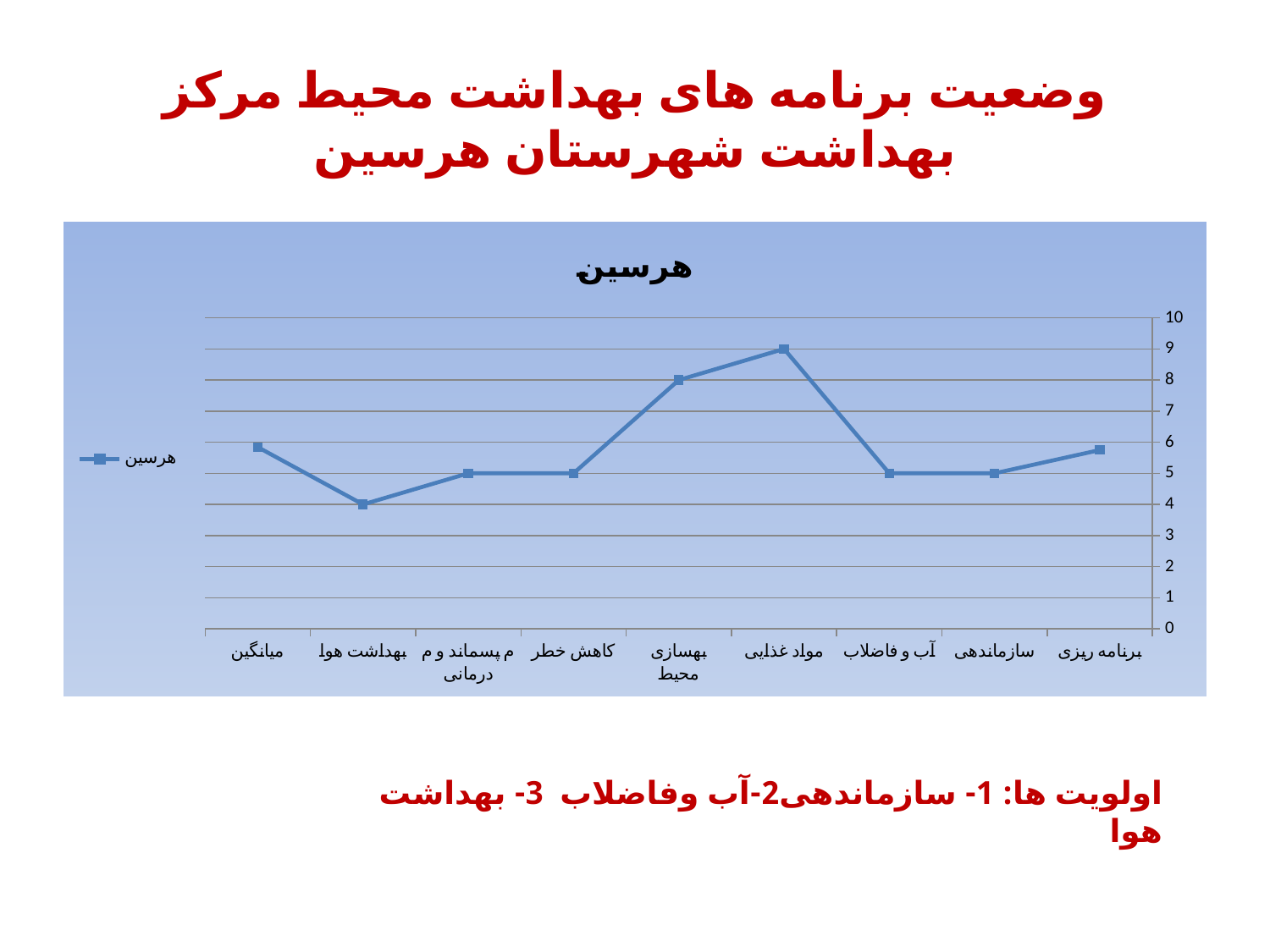
What is the value for سازماندهی? 5 How many categories are plotted along the x axis? 9 What is the value for بهداشت هوا? 4 Is the value for میانگین greater or less than 5? greater How many series does the legend list? 1 What type of chart is shown on the slide? line chart What is the title of the chart? هرسین Which category has the lowest value? بهداشت هوا What is the value for بهسازی محیط? 8